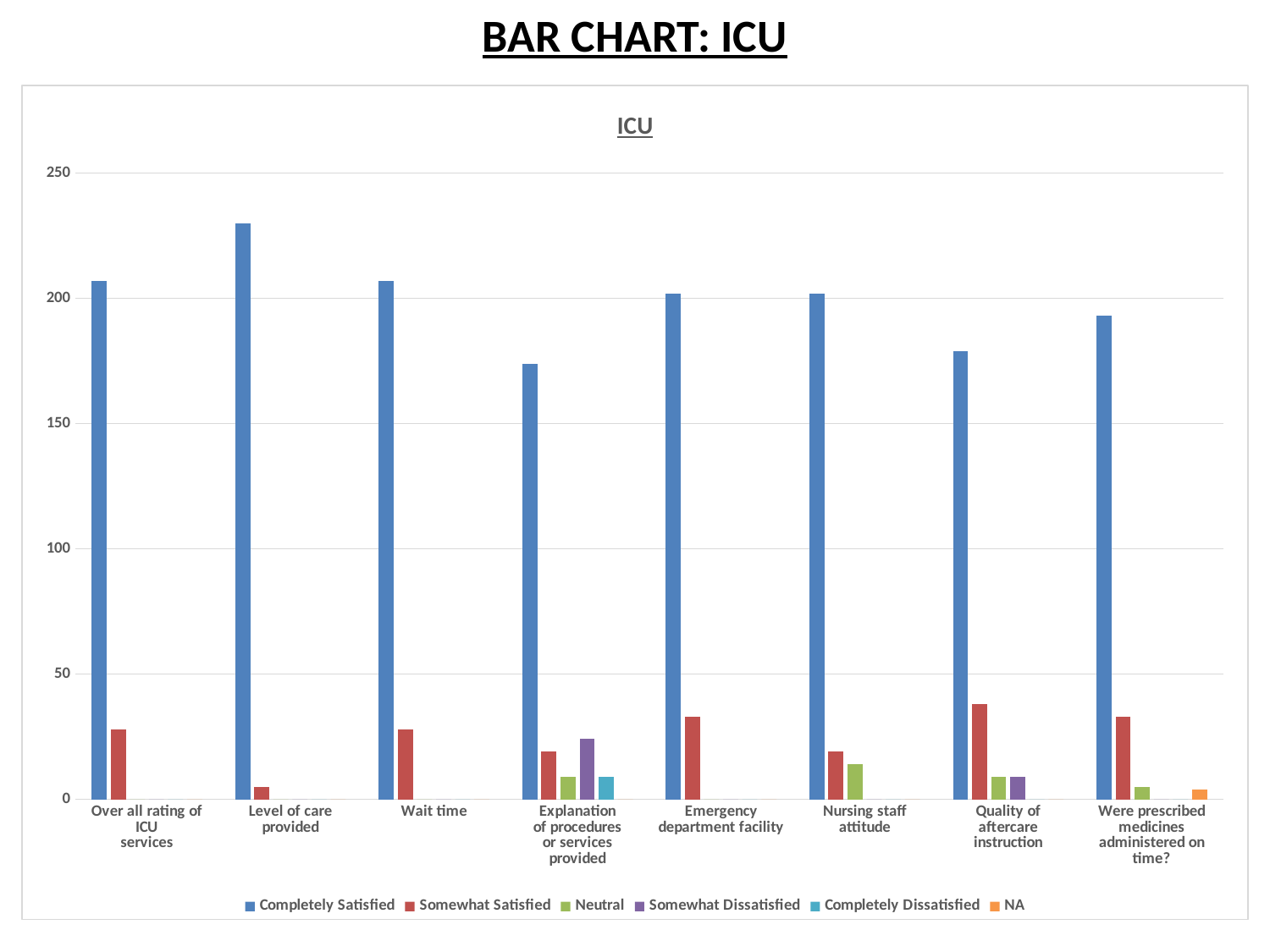
Is the Somewhat Satisfied value for Quality of aftercare instruction greater or less than 50? less How many series does the legend of the ICU chart list? 6 Which category has the highest Somewhat Satisfied value? Quality of aftercare instruction Is the Completely Satisfied value for Level of care provided greater or less than 200? greater How many categories are shown along the x axis of the ICU chart? 8 Which category is the only one with a visible NA bar? Were prescribed medicines administered on time? What is the title shown inside the chart area? ICU What kind of chart is shown on the slide? bar chart Is the Completely Satisfied value for Explanation of procedures or services provided greater or less than 200? less Which category has the lowest Somewhat Satisfied value? Level of care provided Which category has the highest Completely Satisfied value? Level of care provided Which is larger: the Completely Satisfied value for Level of care provided or for Quality of aftercare instruction? Level of care provided